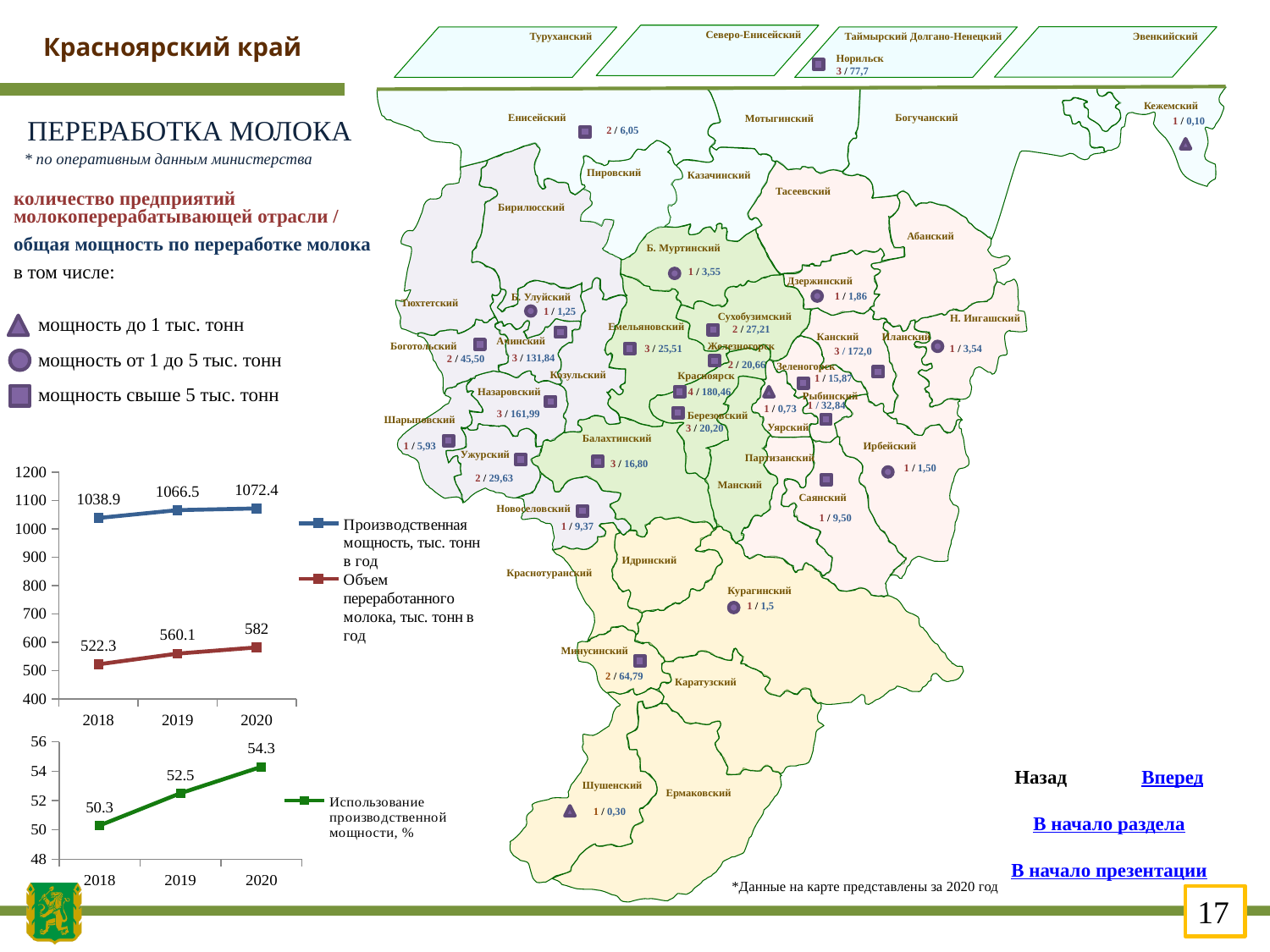
On the upper line chart, what is the value of Объем переработанного молока, тыс. тонн в год for 2020? 582 On the upper line chart, what is the value of Производственная мощность, тыс. тонн в год for 2020? 1072.4 On the lower line chart, what is the difference between the 2020 and 2018 values of Использование производственной мощности, %? 4 On the lower line chart, how many years are plotted on the x axis? 3 What type of chart is the lower chart showing Использование производственной мощности, %? line chart On the upper line chart, how many series does the legend list? 2 On the upper line chart, what is the value of Объем переработанного молока, тыс. тонн в год for 2018? 522.3 On the lower line chart, what is the value of Использование производственной мощности, % for 2019? 52.5 On the upper line chart, does Объем переработанного молока rise or fall from 2018 to 2020? rise On the upper line chart, in which year is Объем переработанного молока lowest? 2018 On the upper line chart, in which year is Производственная мощность highest? 2020 On the upper line chart, what is the difference between Производственная мощность and Объем переработанного молока in 2019? 506.4